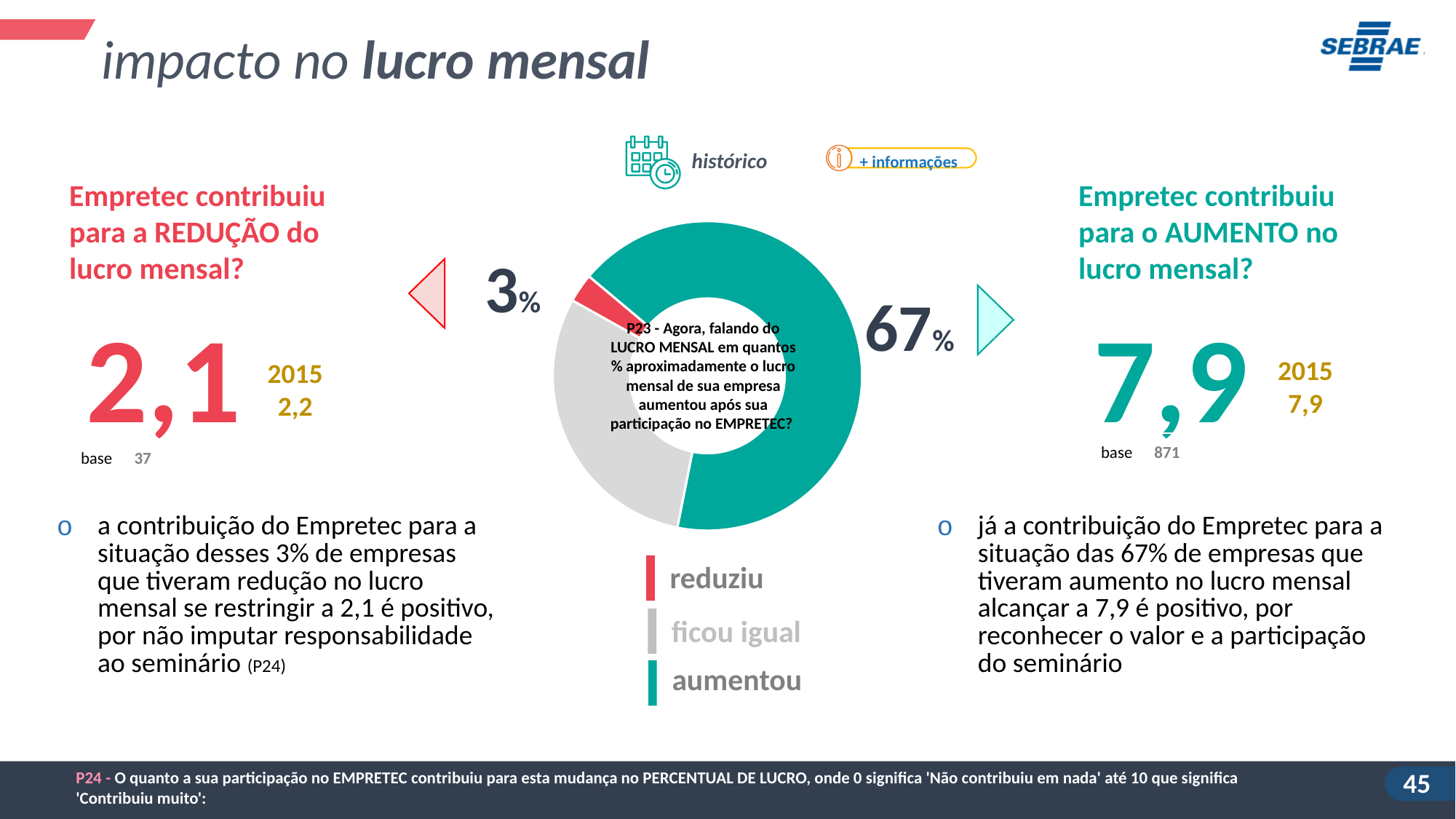
Which category has the smallest slice of the donut chart? reduziu Which category has the largest slice of the donut chart? aumentou What kind of chart is shown in the centre of the slide? Donut (pie) chart What colour represents the 'reduziu' category in the donut chart? Red How many categories does the legend of the donut chart list? 3 What is the difference in percentage points between the 'aumentou' slice and the 'reduziu' slice? 64 percentage points What percentage of companies reported that their monthly profit increased (aumentou)? 67% What percentage of companies reported that their monthly profit decreased (reduziu)? 3% Which slice is larger, 'ficou igual' or 'reduziu'? ficou igual What colour represents the 'aumentou' category in the donut chart? Teal (green) Which slice is larger, 'ficou igual' or 'aumentou'? aumentou What share of the donut chart does the 'aumentou' slice represent? 67%